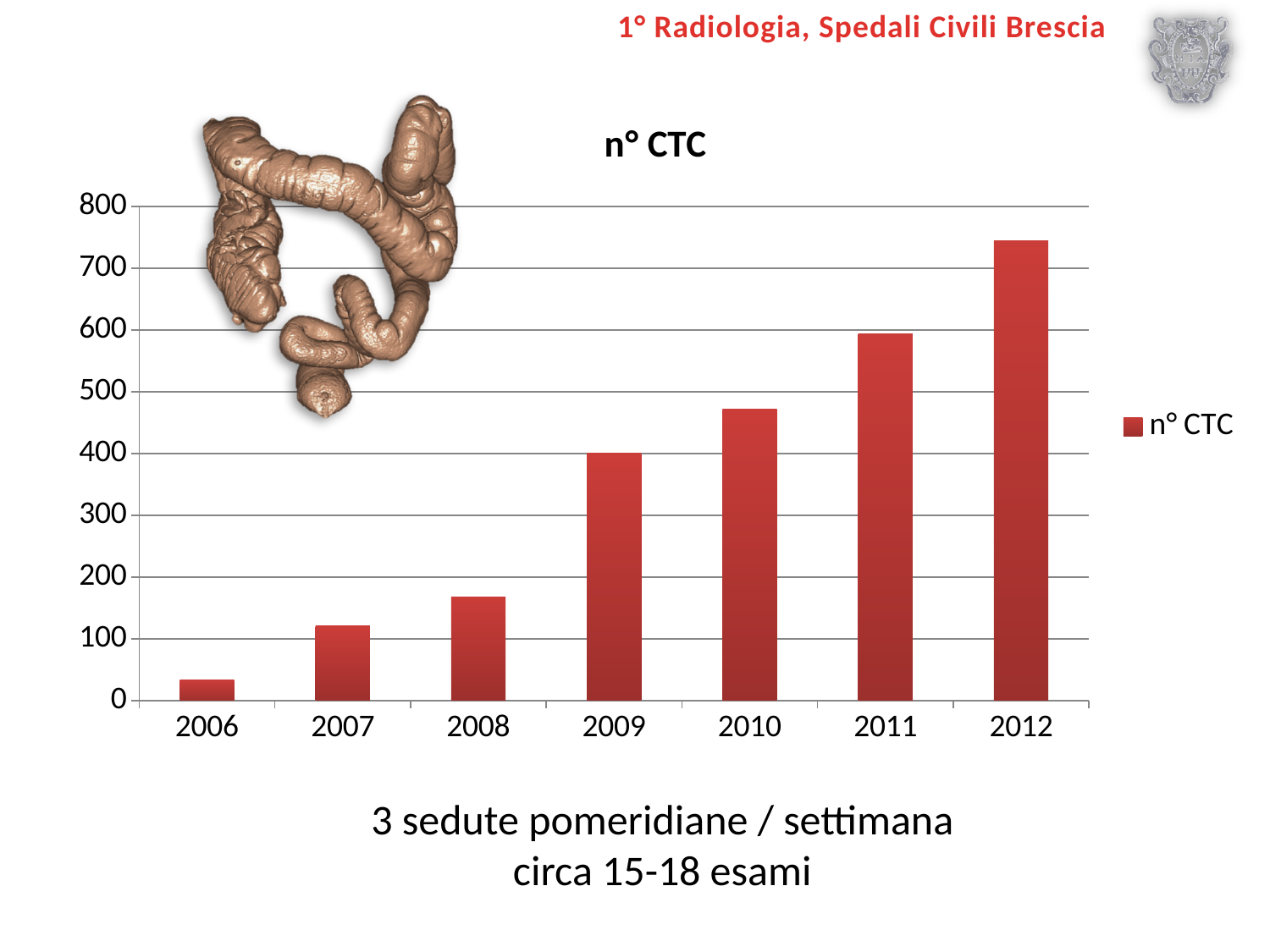
Is the value for 2010 greater or less than 400? greater Is the value for 2008 greater or less than 200? less Which year has the highest value? 2012 How many series does the legend list? 1 Which is larger, the value for 2011 or the value for 2009? 2011 What type of chart is shown on the slide? bar chart How many years are shown on the x axis of the chart? 7 Which year has the lowest value? 2006 Is the value for 2012 greater or less than 700? greater What is the title of the chart? n° CTC Do the values rise or fall from 2006 to 2012? rise